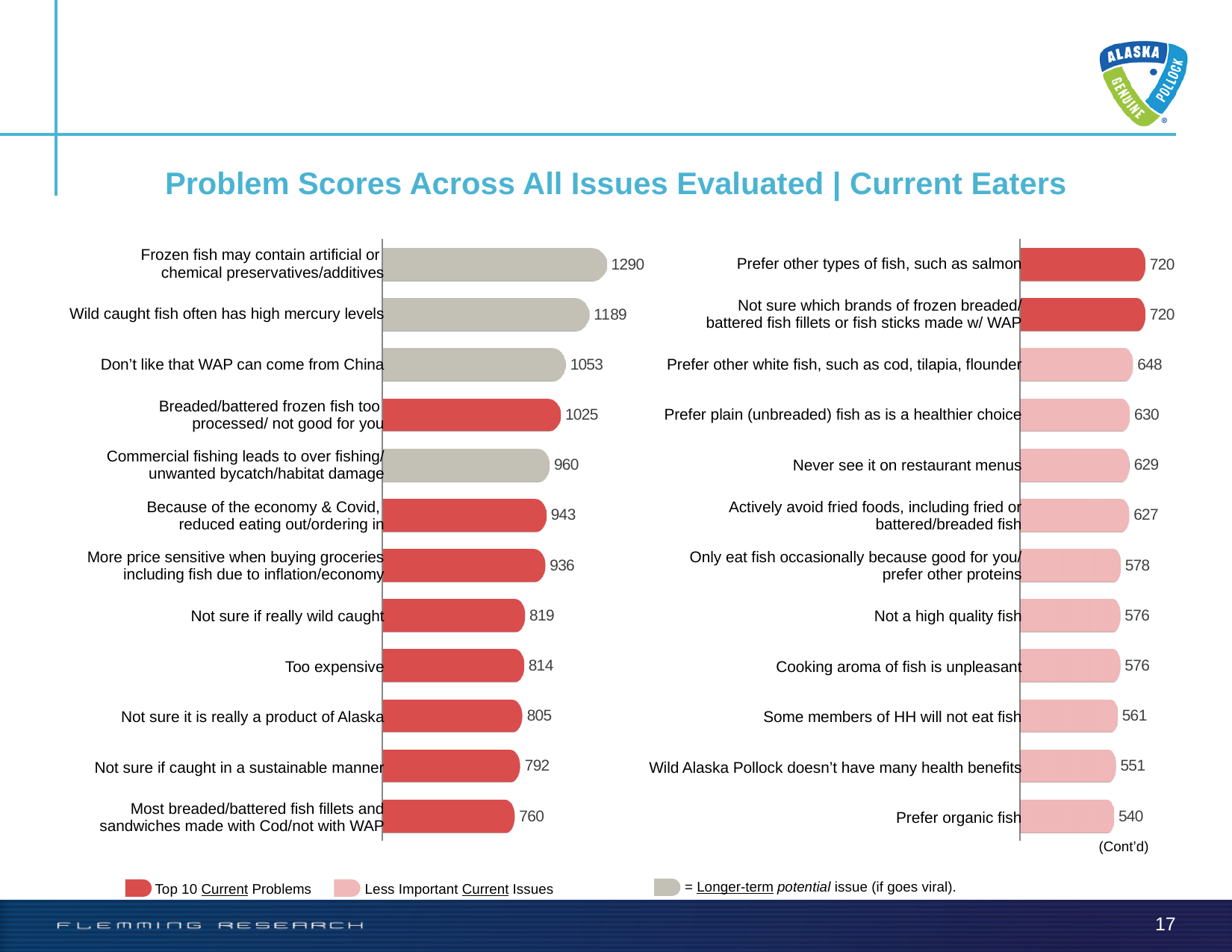
In the left chart, what is the problem score for 'Don't like that WAP can come from China'? 1053 In the right chart, what is the problem score for 'Never see it on restaurant menus'? 629 In the left chart, which issue has the highest problem score? Frozen fish may contain artificial or chemical preservatives/additives How many categories does the legend at the bottom of the slide list? 3 In the left chart, what is the difference between the scores for 'Wild caught fish often has high mercury levels' and 'Too expensive'? 375 How many issues are plotted in the left chart? 12 In the left chart, do the problem scores increase or decrease from top to bottom? Decrease In the left chart, which has a higher score: 'Not sure if really wild caught' or 'Not sure if caught in a sustainable manner'? Not sure if really wild caught In the right chart, which issue has the lowest problem score? Prefer organic fish In the right chart, what is the difference between the scores for 'Prefer other white fish, such as cod, tilapia, flounder' and 'Some members of HH will not eat fish'? 87 What type of chart is used on this slide? Bar chart How many issues are plotted in the right chart? 12